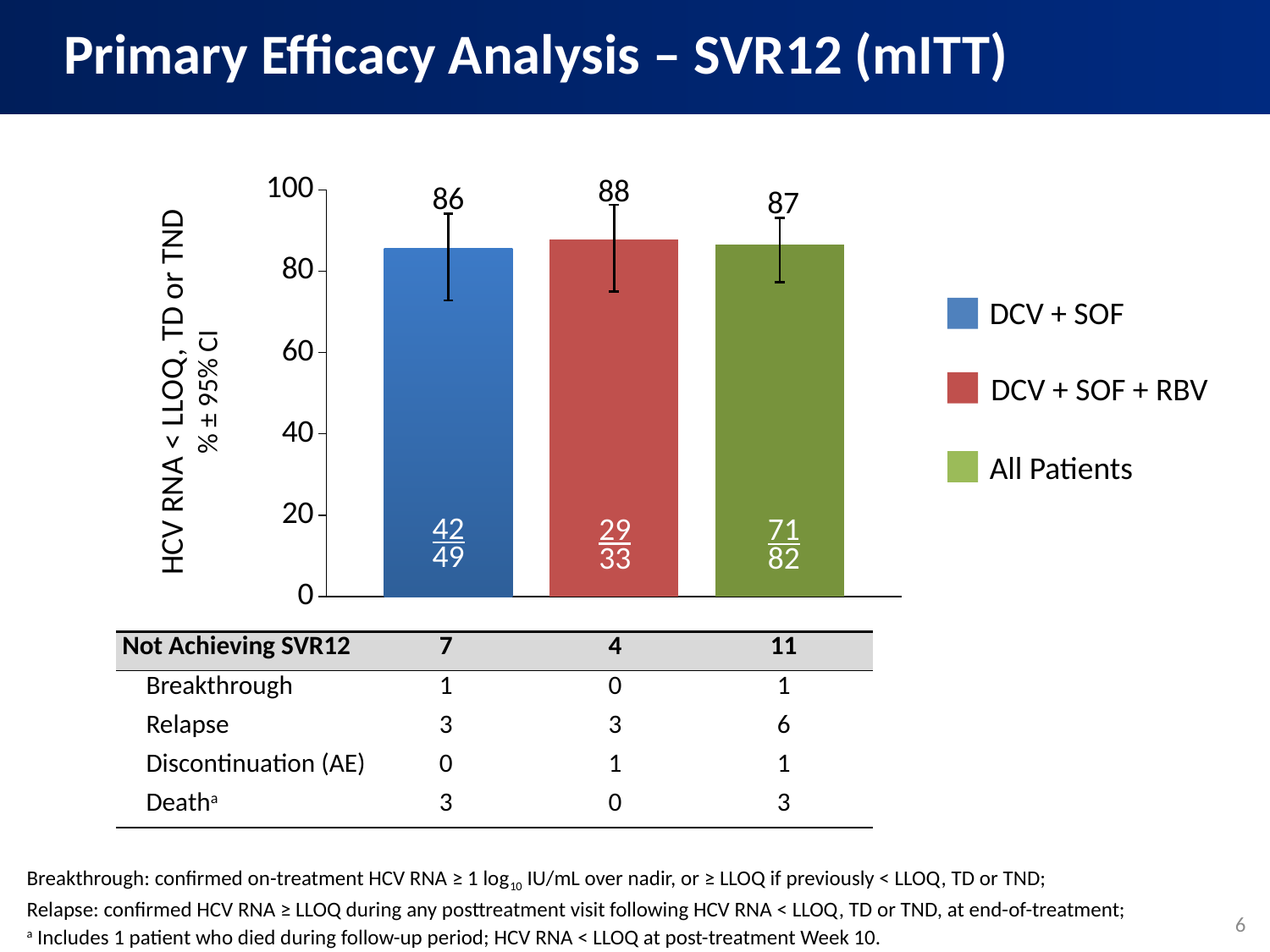
What is the SVR12 rate shown for the DCV + SOF + RBV group? 88 What is the SVR12 rate shown for the DCV + SOF group? 86 What colour is the All Patients bar? green Is the SVR12 rate for DCV + SOF greater or less than 80? greater What fraction is printed inside the DCV + SOF bar? 42/49 How many bars are plotted in the chart? 3 How many entries does the legend list? 3 What fraction is printed inside the All Patients bar? 71/82 What kind of chart is shown on the slide? bar chart Which group has the highest SVR12 rate according to the data labels? DCV + SOF + RBV What is the difference between the SVR12 rates of DCV + SOF + RBV and DCV + SOF? 2 What is the SVR12 rate shown for All Patients? 87